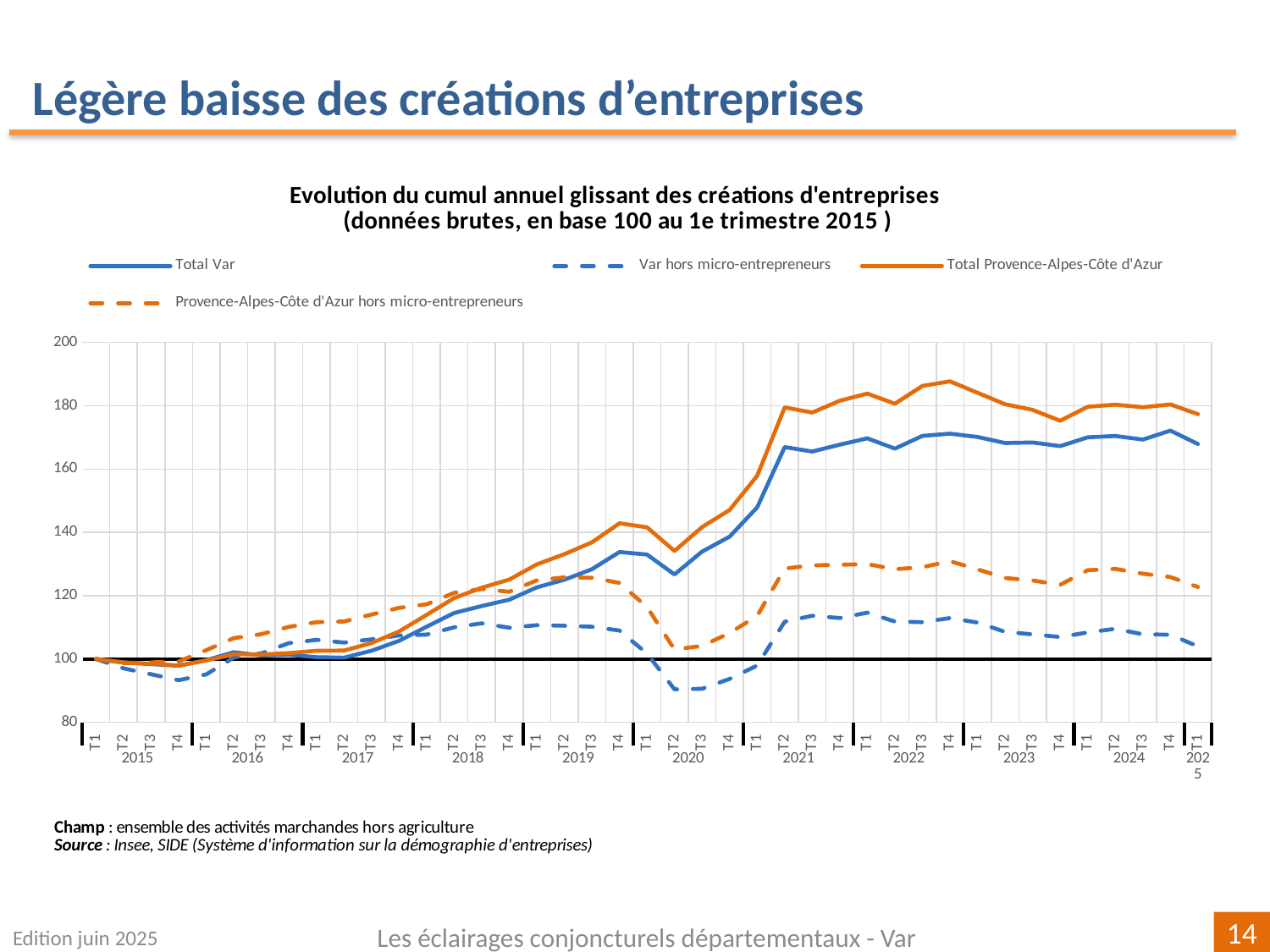
Is the value of Total Var at T2 2020 greater or less than 140? less What colour are the lines for the Provence-Alpes-Côte d'Azur series? orange Does the Total Var series rise or fall between T1 2020 and T2 2021? rise Which series has the highest value at T4 2022? Total Provence-Alpes-Côte d'Azur At T1 2025, which is higher: Total Var or Total Provence-Alpes-Côte d'Azur? Total Provence-Alpes-Côte d'Azur Is the value of Total Provence-Alpes-Côte d'Azur at T4 2022 greater or less than 180? greater How many series does the legend list? 4 What is the value of the Total Var series at T1 2015, the base period? 100 What kind of chart is shown on the slide? line chart Is the value of Provence-Alpes-Côte d'Azur hors micro-entrepreneurs at T2 2021 greater or less than 120? greater